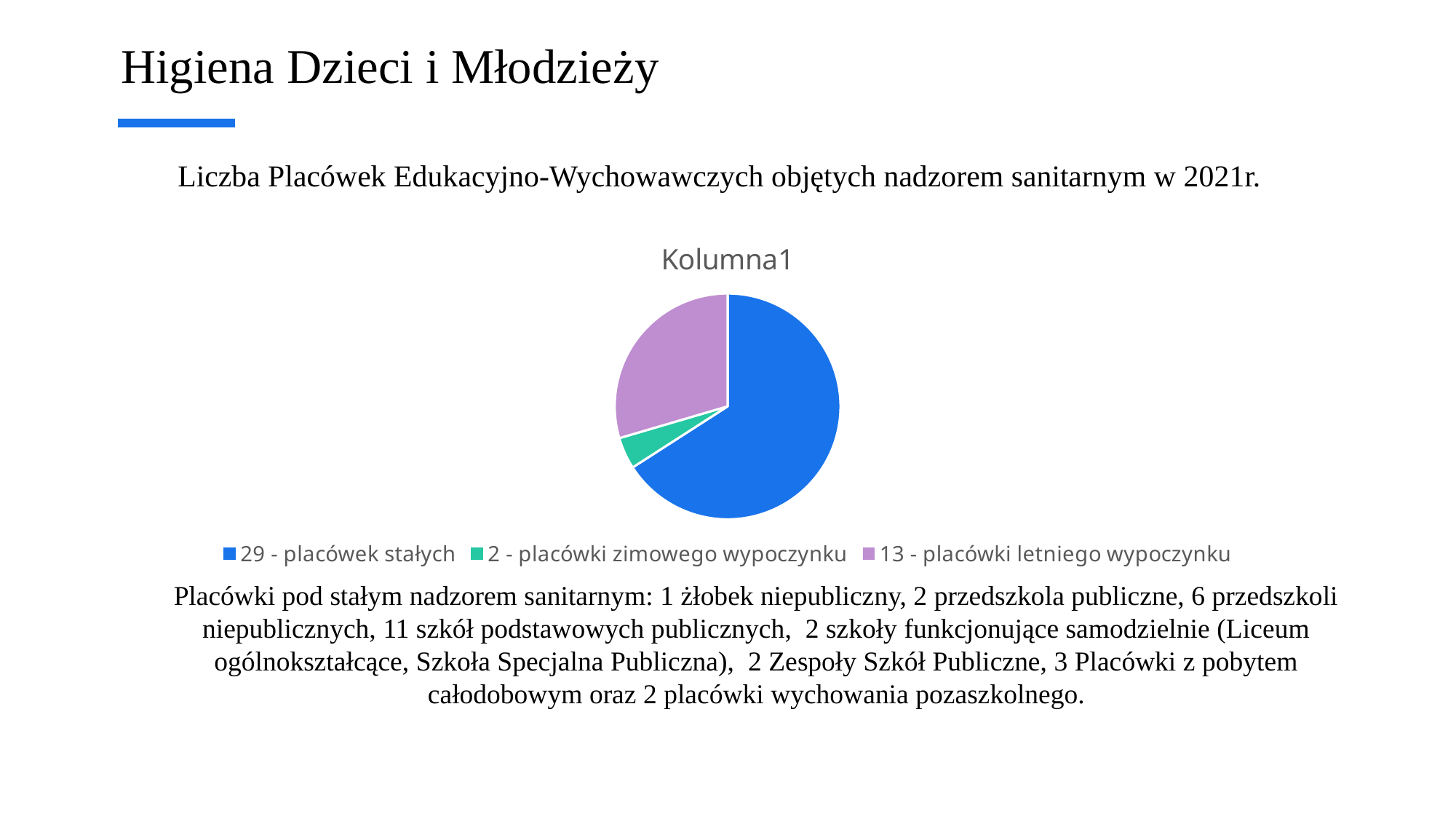
How many placówek stałych are shown in the pie chart legend? 29 What is the title shown above the pie chart? Kolumna1 What is the total number of placówki across all three slices of the pie chart? 44 Which category has the largest slice of the pie chart? placówek stałych Which is larger: placówki letniego wypoczynku or placówki zimowego wypoczynku? placówki letniego wypoczynku How many entries does the legend of the pie chart list? 3 How many placówki zimowego wypoczynku are shown in the pie chart legend? 2 How many slices does the pie chart have? 3 What kind of chart is shown on the slide? pie chart How many placówki letniego wypoczynku are shown in the pie chart legend? 13 What is the difference between the number of placówek stałych and placówki letniego wypoczynku? 16 Which category has the smallest slice of the pie chart? placówki zimowego wypoczynku